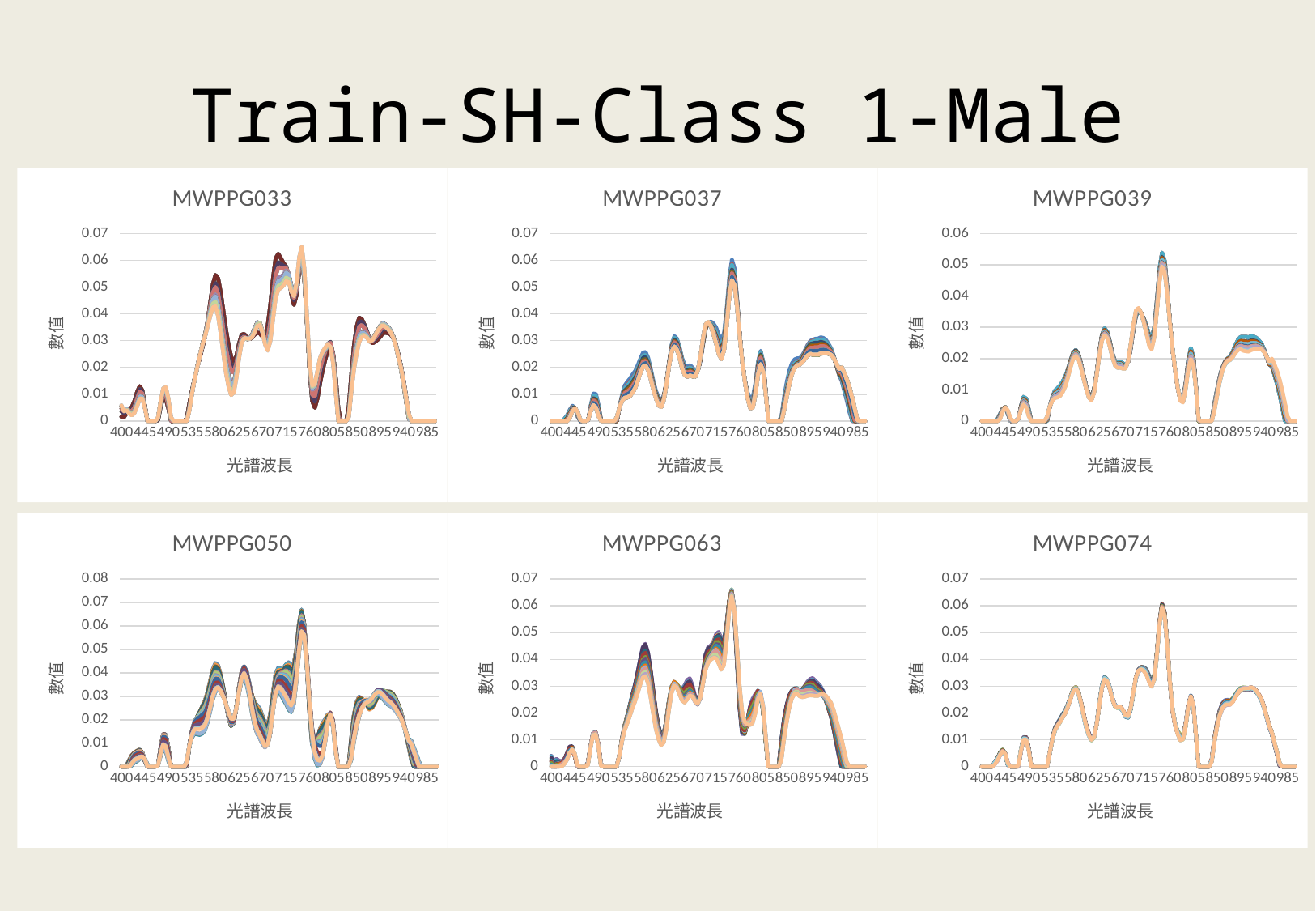
What is the first wavelength label on the x-axis of the MWPPG033 chart? 400 In the MWPPG050 chart, is the peak value near wavelength 760 greater or less than 0.05? greater What kind of chart is MWPPG033? line chart What is the title of the chart in the top-left position? MWPPG033 In the MWPPG039 chart, what is the highest value shown on the y-axis? 0.06 In the MWPPG063 chart, is the peak value near wavelength 580 greater or less than 0.06? less In the MWPPG074 chart, do the values rise or fall between wavelength 940 and 985? fall In the MWPPG037 chart, is the value near wavelength 445 greater or less than 0.02? less In the MWPPG050 chart, what is the highest value shown on the y-axis? 0.08 What is the x-axis title of the MWPPG074 chart? 光譜波長 How many charts are shown on the slide? 6